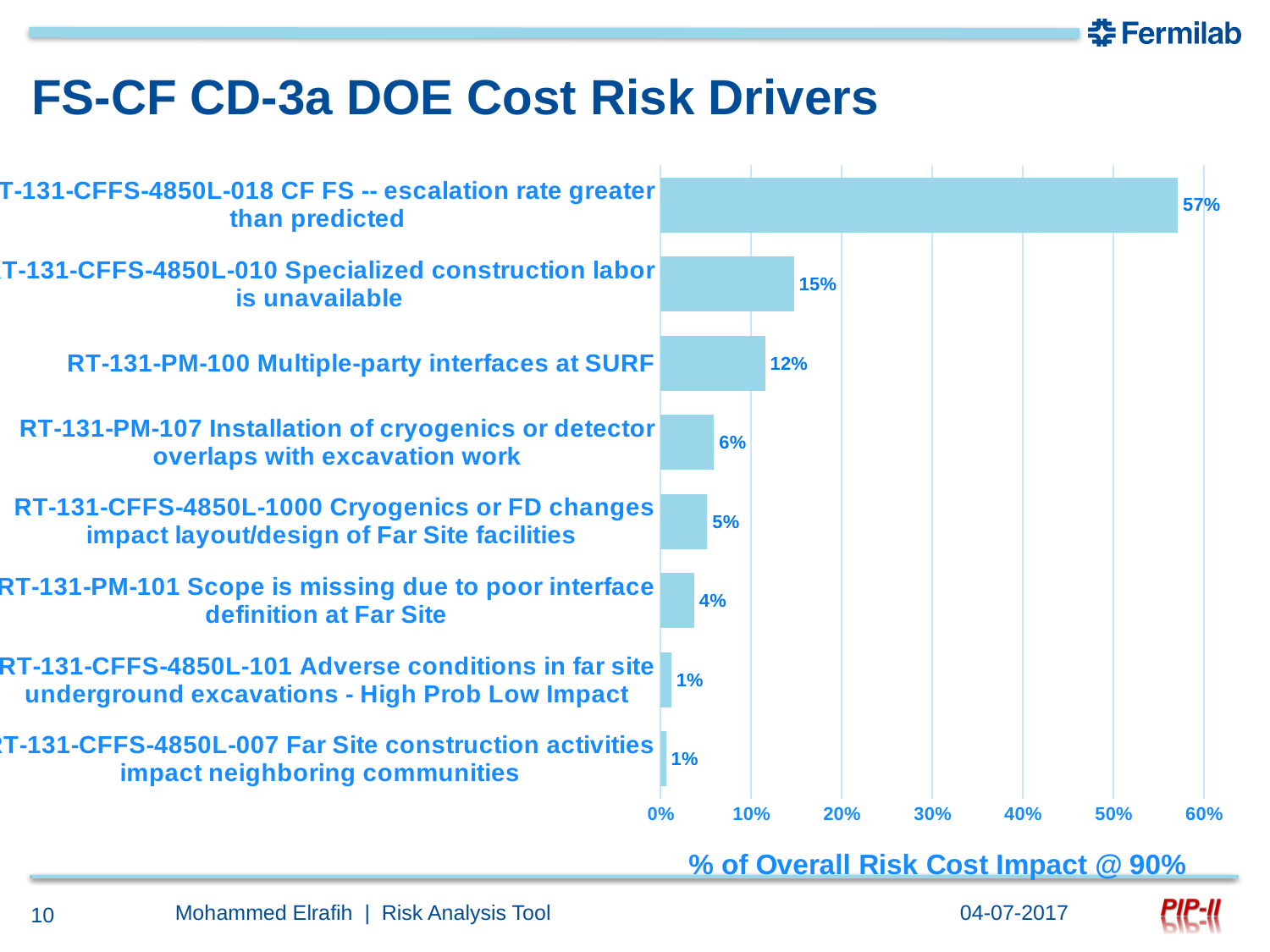
Which risk driver has the highest % of Overall Risk Cost Impact? CF FS -- escalation rate greater than predicted What is the value for the 'Specialized construction labor is unavailable' risk? 15% What kind of chart is shown on the slide? bar chart What is the difference between the 'escalation rate greater than predicted' risk and the 'Specialized construction labor is unavailable' risk? 42% What is the value for RT-131-PM-100 Multiple-party interfaces at SURF? 12% What is the value for the 'Far Site construction activities impact neighboring communities' risk? 1% What is the value for RT-131-PM-101 Scope is missing due to poor interface definition at Far Site? 4% Which is larger: the value for 'Cryogenics or FD changes impact layout/design of Far Site facilities' or the value for 'Multiple-party interfaces at SURF'? Multiple-party interfaces at SURF What is the x-axis label of the chart? % of Overall Risk Cost Impact @ 90% Is the value for the 'escalation rate greater than predicted' risk greater or less than 50%? greater How many risk drivers are plotted in the chart? 8 What is the value for RT-131-PM-107 Installation of cryogenics or detector overlaps with excavation work? 6%